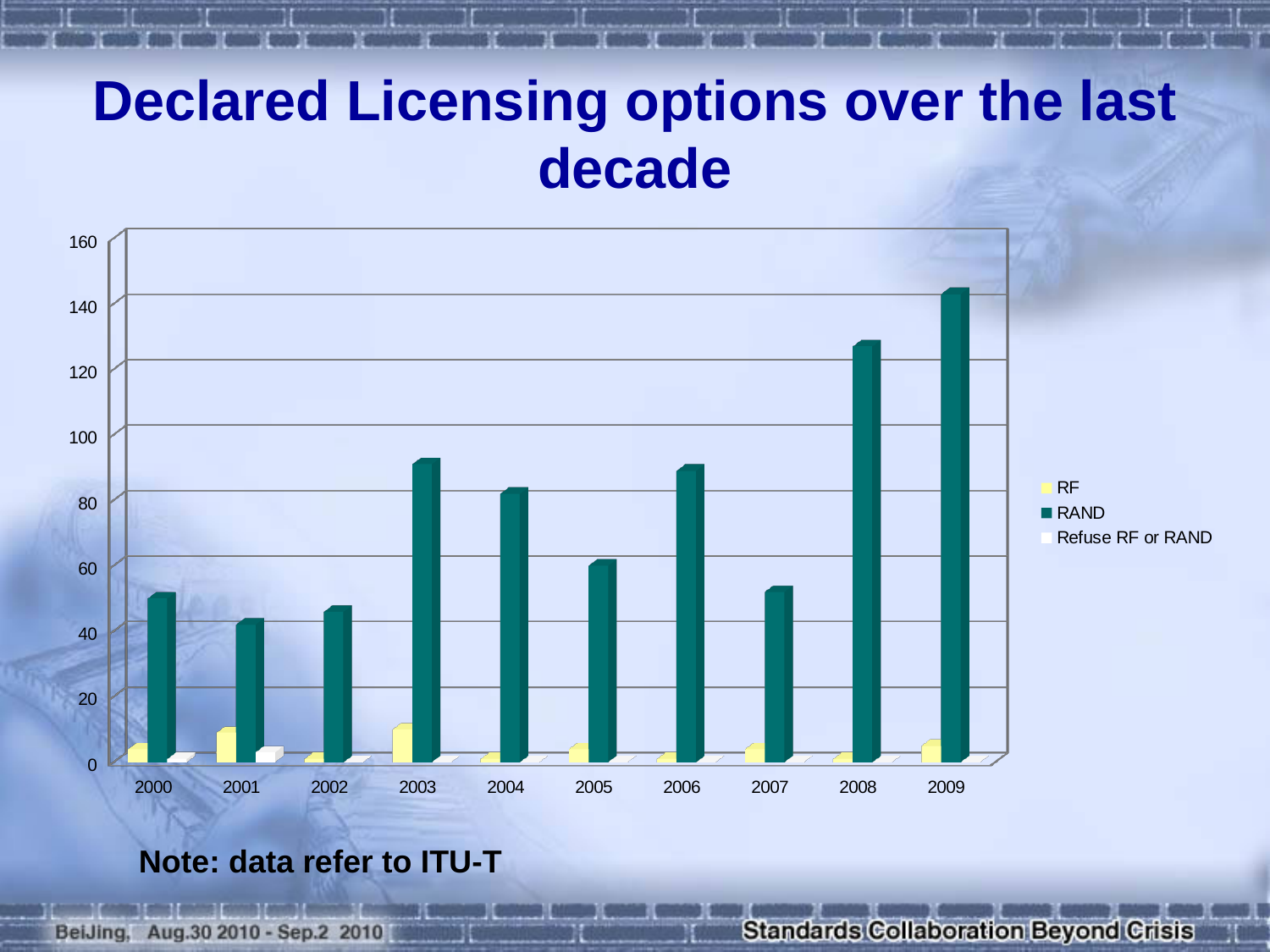
Is the RAND value for 2005 greater or less than 80? less How many years are shown along the x axis? 10 Do the RAND values rise or fall from 2007 to 2009? rise What is the title of the chart? Declared Licensing options over the last decade What kind of chart is shown on the slide? bar chart Is the RAND value for 2003 greater or less than 80? greater Which year has the larger RAND value, 2006 or 2007? 2006 How many series does the legend list? 3 In which year is the RAND value highest? 2009 Is the RAND value for 2008 greater or less than 120? greater Which year has the larger RAND value, 2008 or 2003? 2008